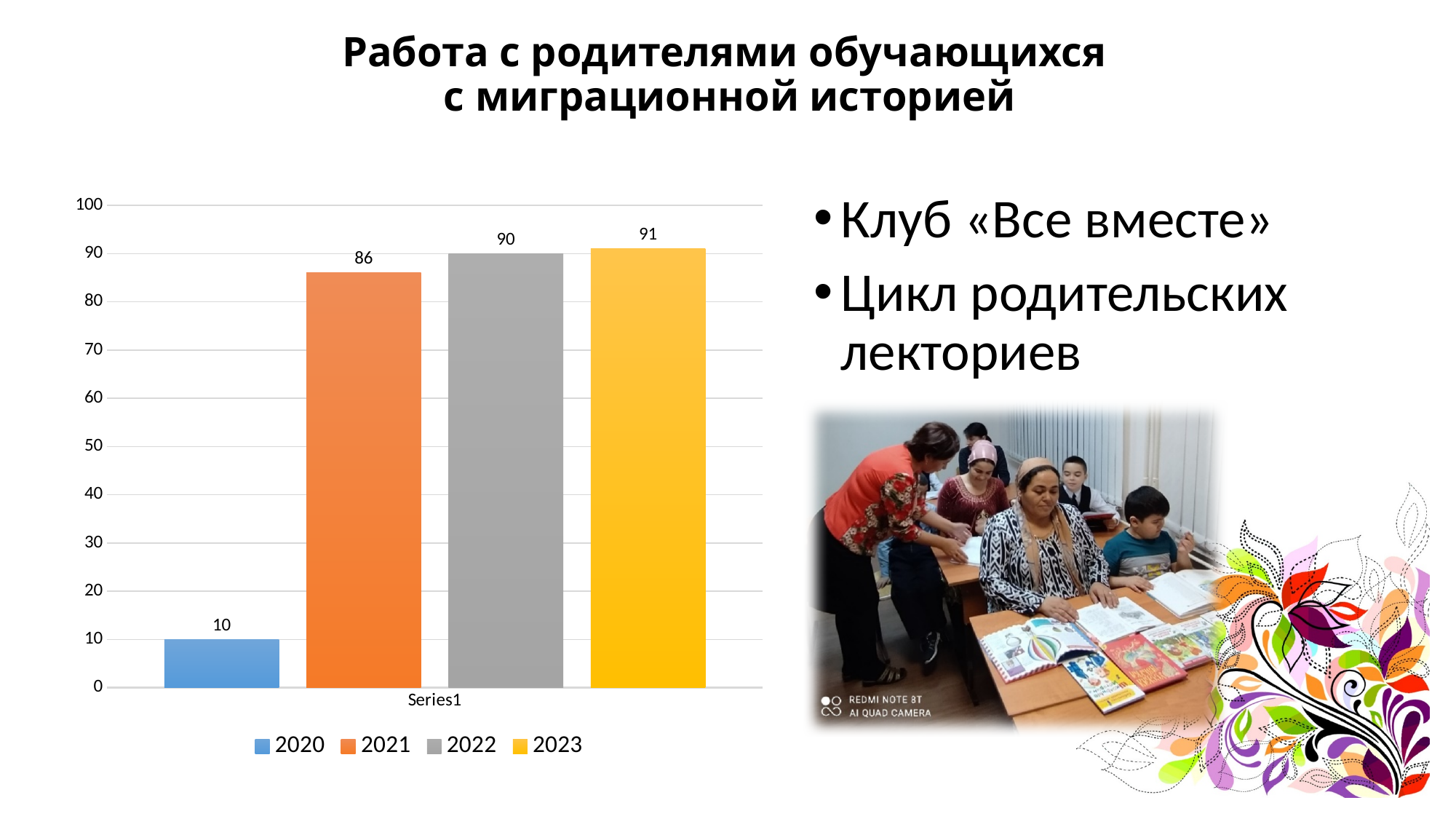
Which is larger, the value for 2021 or the value for 2020? 2021 What is the value for 2021? 86 What is the value for 2020? 10 Which year has the highest value? 2023 What is the difference between the values for 2023 and 2022? 1 What is the difference between the values for 2021 and 2020? 76 Which year has the lowest value? 2020 How many bars are plotted in the chart? 4 What is the value for 2022? 90 What kind of chart is shown on the slide? Bar chart How many entries does the legend list? 4 What is the value for 2023? 91